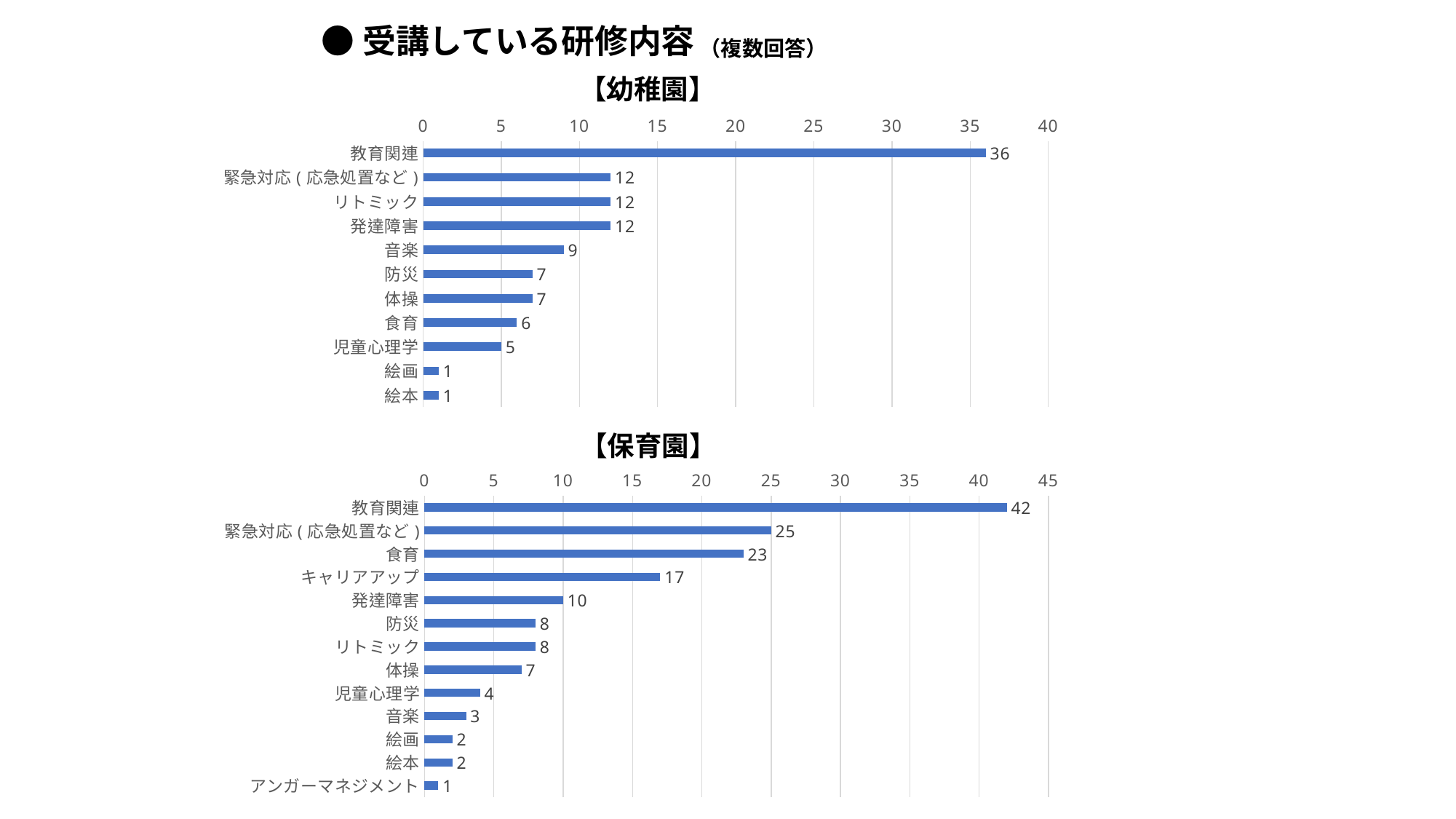
In the 【幼稚園】 chart, what is the value for 教育関連? 36 How many categories are shown in the 【保育園】 chart? 13 In the 【保育園】 chart, what is the difference between 教育関連 and 緊急対応 ( 応急処置など )? 17 In the 【保育園】 chart, is the value for 発達障害 greater or less than 15? less In the 【幼稚園】 chart, what is the difference between 教育関連 and 音楽? 27 What kind of chart is the 【保育園】 chart? bar chart In the 【保育園】 chart, which category has the lowest value? アンガーマネジメント In the 【幼稚園】 chart, which category has the highest value? 教育関連 How many categories are shown in the 【幼稚園】 chart? 11 In the 【保育園】 chart, what is the value for キャリアアップ? 17 In the 【保育園】 chart, what is the value for 食育? 23 In the 【幼稚園】 chart, which is larger, 音楽 or 児童心理学? 音楽